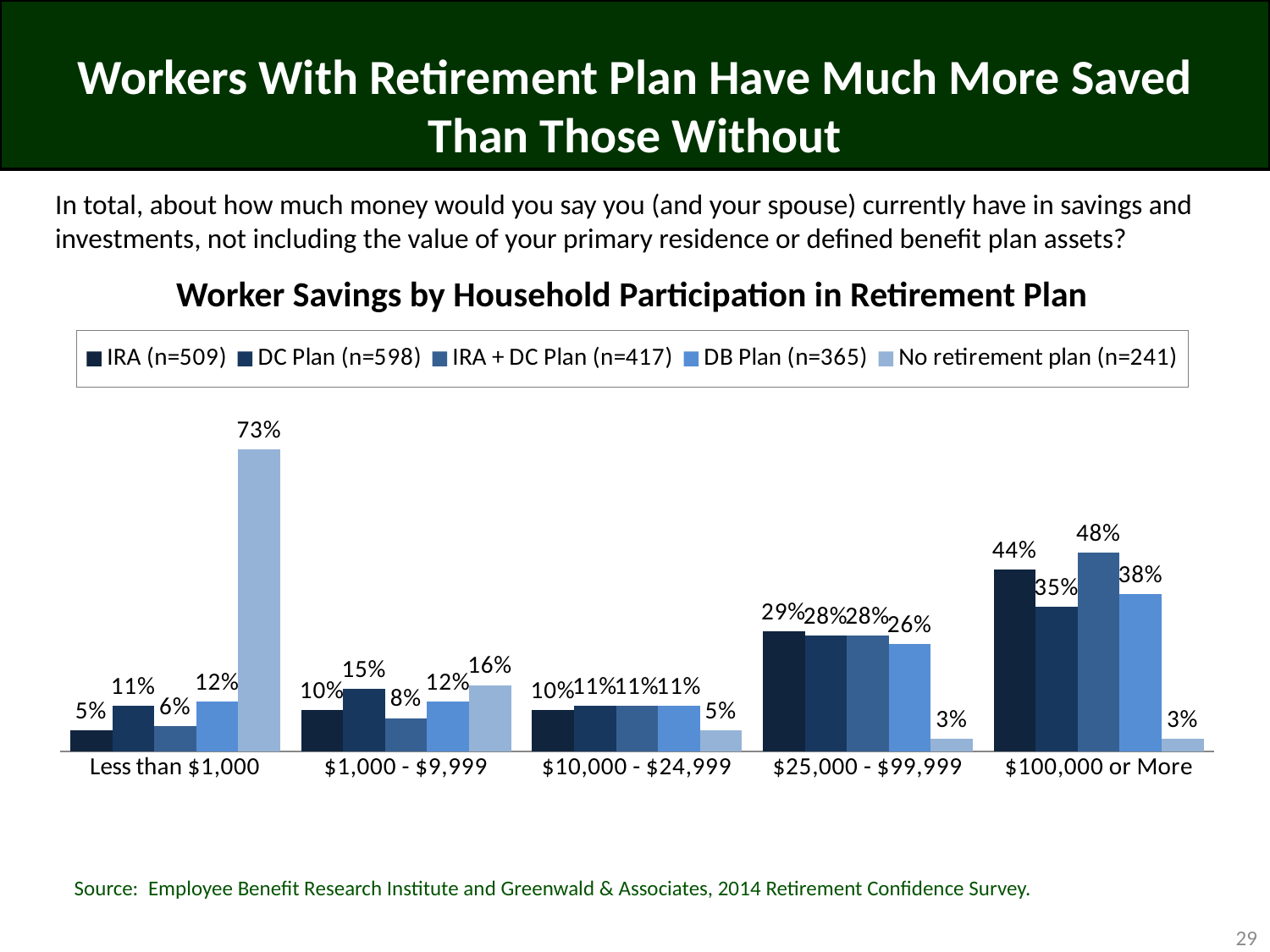
What is the value for DB Plan in the $25,000 - $99,999 category? 26% Does the No retirement plan series rise or fall from Less than $1,000 to $100,000 or More? Fall How many savings categories are shown on the x axis? 5 How many series does the legend list? 5 What is the title of the chart? Worker Savings by Household Participation in Retirement Plan What is the difference between the IRA value and the DC Plan value in the $100,000 or More category? 9% What is the value for IRA + DC Plan in the $100,000 or More category? 48% Which is larger in the Less than $1,000 category: the DC Plan value or the DB Plan value? DB Plan What is the value for No retirement plan in the Less than $1,000 category? 73% Which series has the highest value in the $1,000 - $9,999 category? No retirement plan (n=241) Which series has the lowest value in the $100,000 or More category? No retirement plan (n=241) What kind of chart is shown on the slide? Bar chart